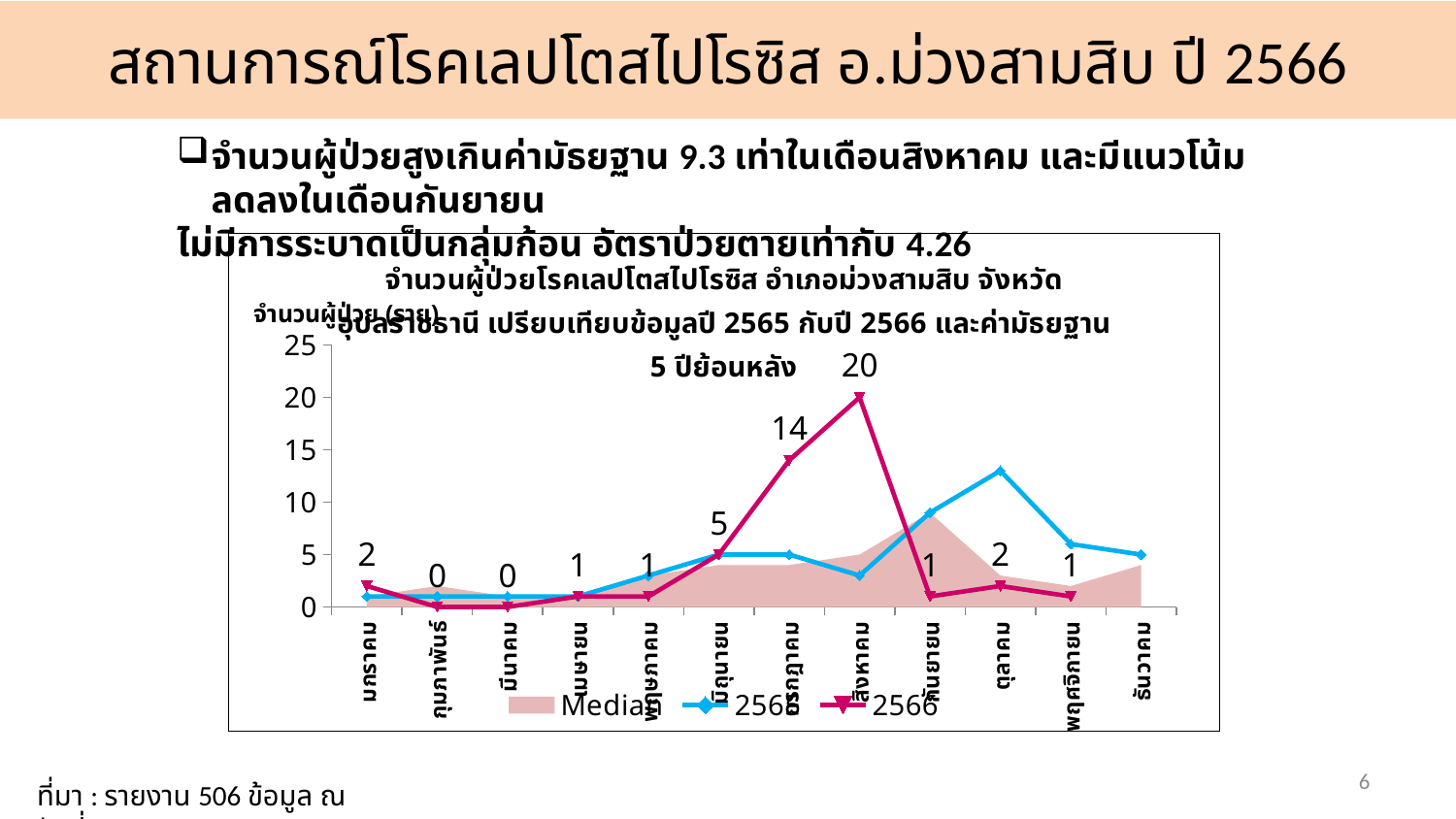
How many series does the legend list? 3 What kind of chart is shown on the slide? Combination area and line chart (two line series with a shaded area for the median) Does the 2566 series rise or fall from มิถุนายน to สิงหาคม? rise What is the value for the 2566 series in กรกฎาคม? 14 What is the difference between the 2566 values for สิงหาคม and กรกฎาคม? 6 How many months are shown on the x axis? 12 In which month does the 2566 series reach its highest value? สิงหาคม Is the value for the 2565 series in มกราคม greater or less than 5? less In ตุลาคม, which series has the larger value, 2565 or 2566? 2565 Is the value for the 2565 series in ตุลาคม greater or less than 10? greater What is the value for the 2566 series in สิงหาคม? 20 What is the value for the 2566 series in มิถุนายน? 5